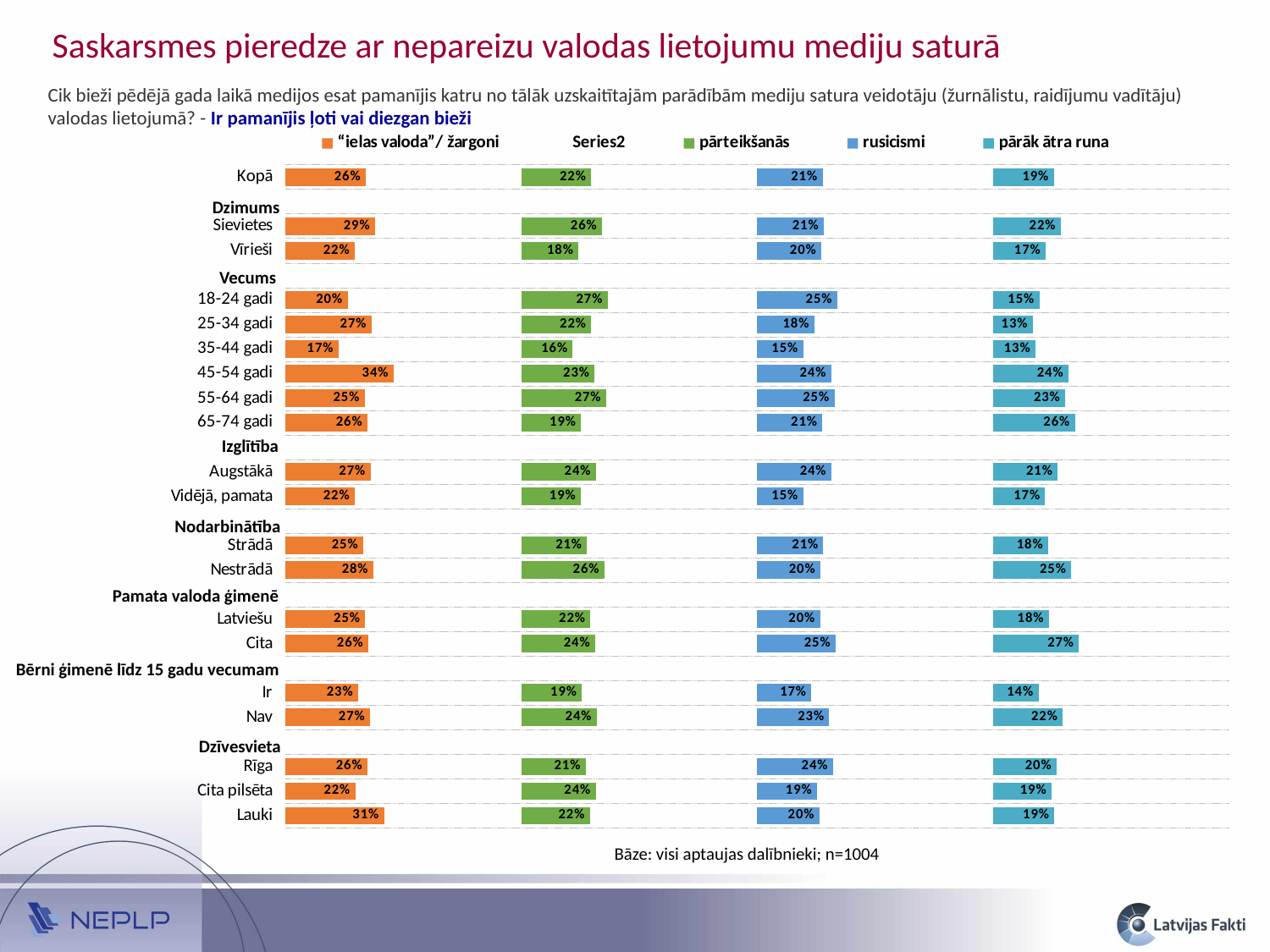
What is the difference between the pārāk ātra runa values for Nestrādā and Strādā? 7% Which category has the lowest value for "ielas valoda"/žargoni? 35-44 gadi How many entries does the legend list? 5 What is the value for rusicismi for 18-24 gadi? 25% Which is larger for Lauki: "ielas valoda"/žargoni or pārteikšanās? "ielas valoda"/žargoni What is the value for pārāk ātra runa for Cita (Pamata valoda ģimenē)? 27% Which category has the highest value for "ielas valoda"/žargoni? 45-54 gadi What is the value for "ielas valoda"/žargoni in the Kopā row? 26% What is the pārteikšanās value for Cita pilsēta? 24% What kind of chart is shown on the slide? Bar chart What is the difference between the "ielas valoda"/žargoni values for Sievietes and Vīrieši? 7% What base (n) is stated below the chart? n=1004